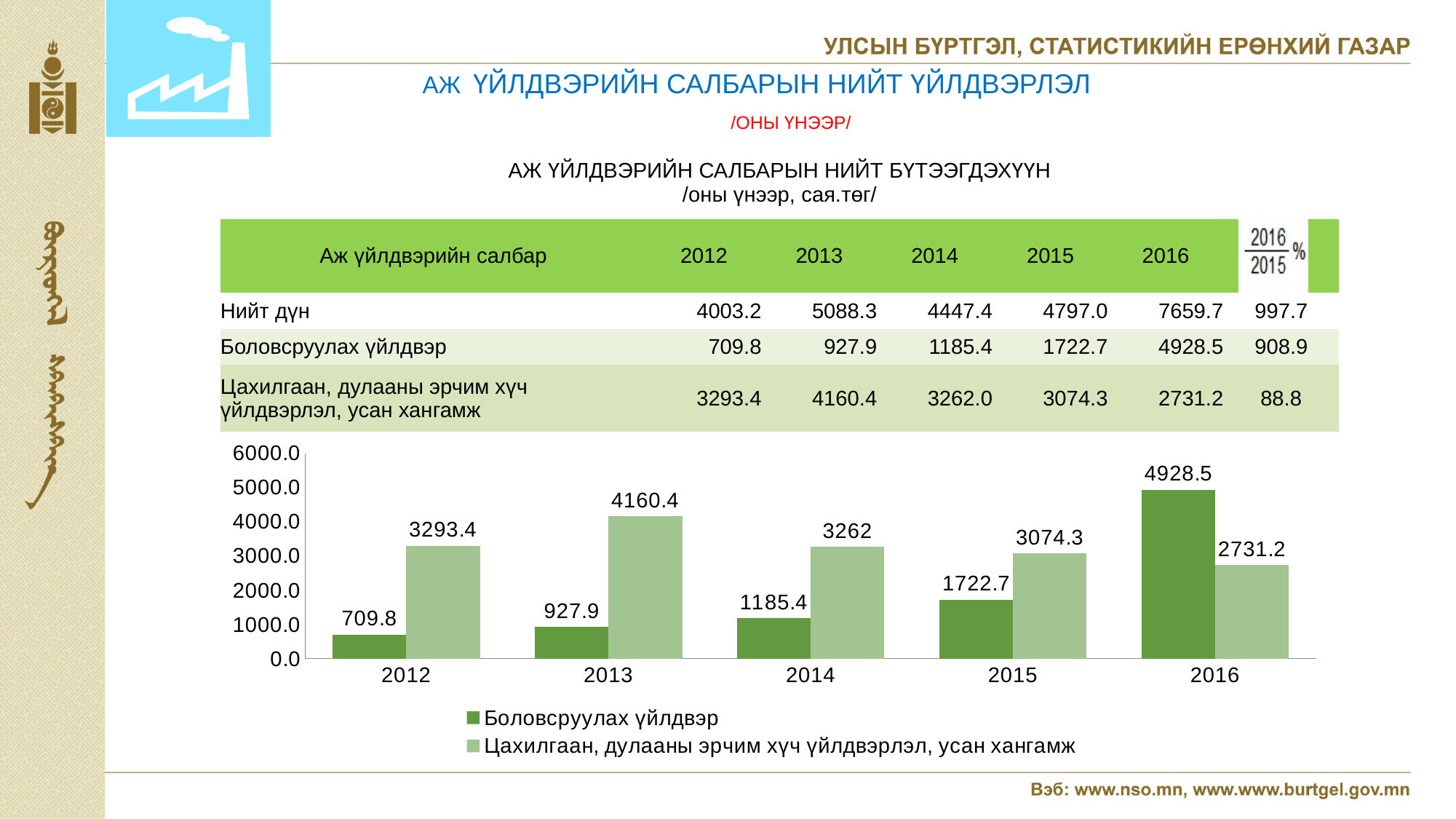
What is the value for Цахилгаан, дулааны эрчим хүч үйлдвэрлэл, усан хангамж in 2013 on the chart? 4160.4 In which year is the Цахилгаан, дулааны эрчим хүч үйлдвэрлэл, усан хангамж bar lowest? 2016 Does the Боловсруулах үйлдвэр series rise or fall from 2012 to 2016? rise Which colour represents Боловсруулах үйлдвэр in the chart? dark green In which year is the Боловсруулах үйлдвэр bar highest? 2016 What is the difference between the Боловсруулах үйлдвэр values for 2016 and 2015 on the chart? 3205.8 What is the value for Боловсруулах үйлдвэр in 2012 on the chart? 709.8 What type of chart is shown on the slide? bar chart What is the value for Боловсруулах үйлдвэр in 2016 on the chart? 4928.5 In 2014, which series has the larger value: Боловсруулах үйлдвэр or Цахилгаан, дулааны эрчим хүч үйлдвэрлэл, усан хангамж? Цахилгаан, дулааны эрчим хүч үйлдвэрлэл, усан хангамж How many series does the chart legend list? 2 How many years are shown on the x axis of the chart? 5